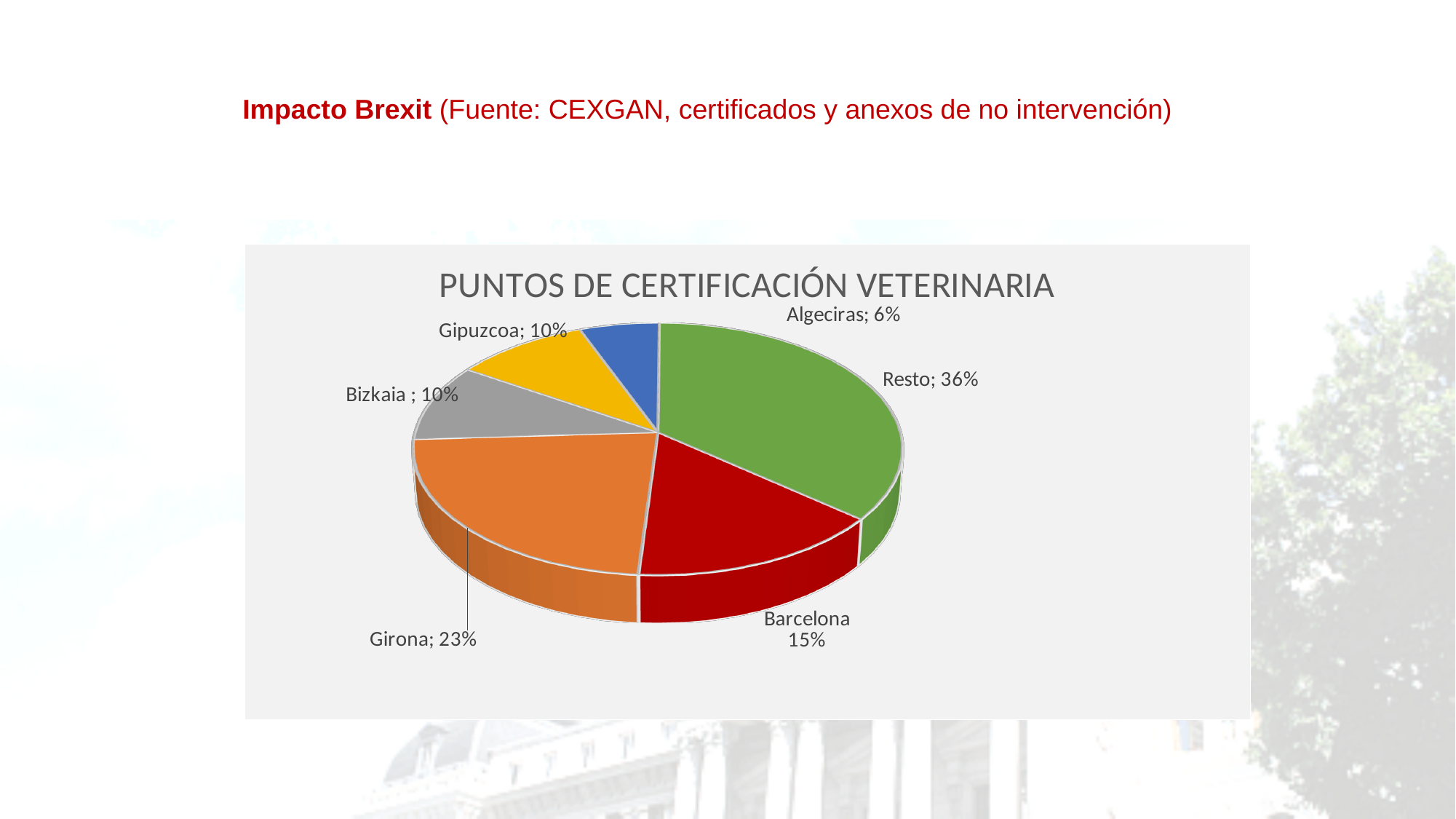
Which category has the largest slice of the pie? Resto What share of the pie does Resto represent? 36% Which is larger, the share for Girona or the share for Gipuzcoa? Girona What colour is the Resto slice? green What share of the pie does Girona represent? 23% What is the difference in percentage points between Girona and Barcelona? 8 What type of chart is shown on the slide? pie chart What share of the pie does Algeciras represent? 6% What is the title of the chart? PUNTOS DE CERTIFICACIÓN VETERINARIA Which category has the smallest slice of the pie? Algeciras What share of the pie does Barcelona represent? 15% How many slices does the pie chart have? 6